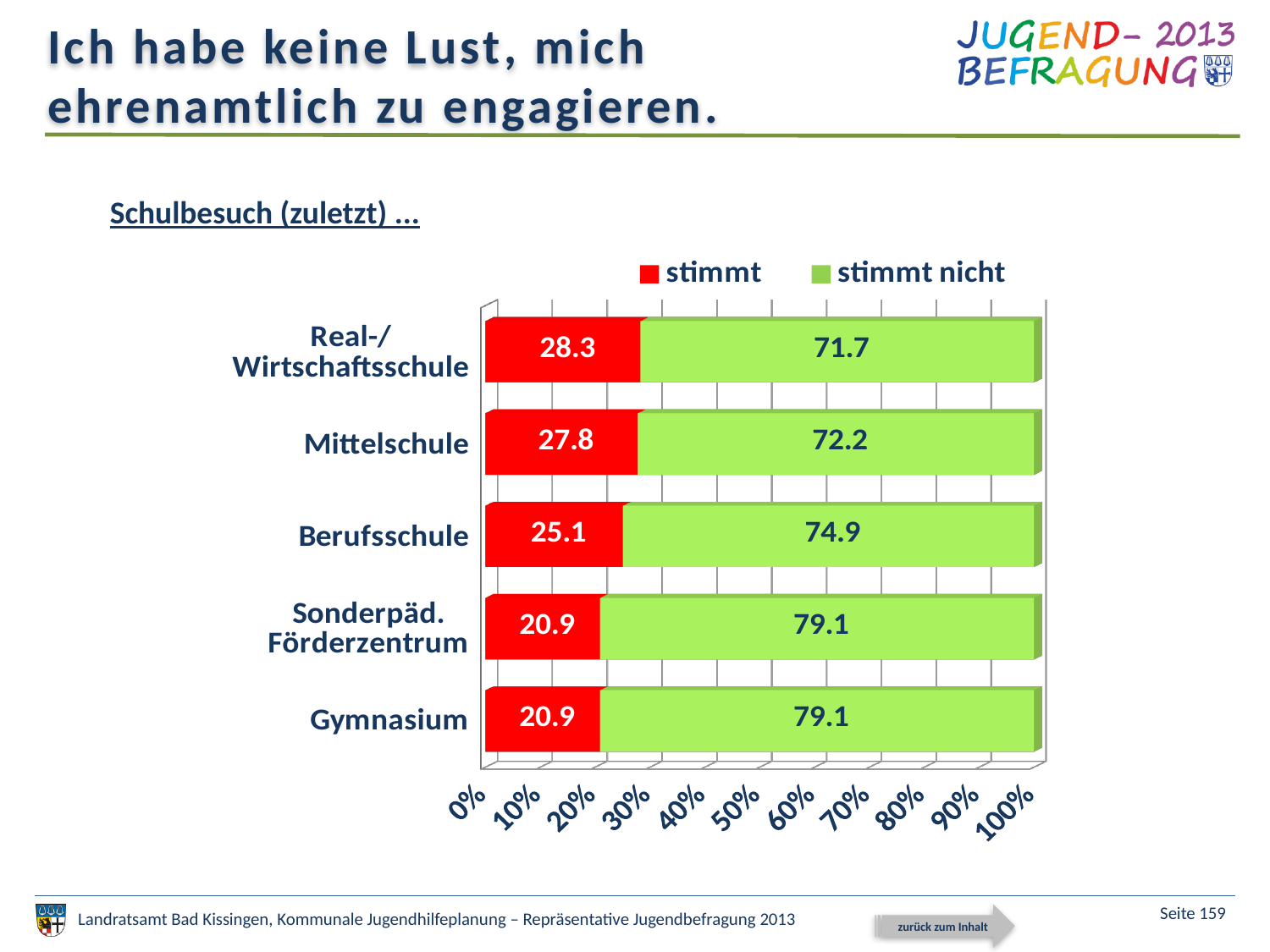
What is the 'stimmt nicht' value for Berufsschule? 74.9 Which is larger, the 'stimmt' value for Berufsschule or for Mittelschule? Mittelschule What is the 'stimmt' value for Mittelschule? 27.8 Which category has the lowest 'stimmt nicht' value? Real-/Wirtschaftsschule What is the total of the stacked bar for Sonderpäd. Förderzentrum? 100 How many series does the legend list? 2 What kind of chart is shown on the slide? Stacked bar chart Which colour represents the 'stimmt nicht' series? Green How many categories are shown on the chart? 5 What is the 'stimmt' value for Real-/Wirtschaftsschule? 28.3 What is the difference between the 'stimmt' values for Real-/Wirtschaftsschule and Gymnasium? 7.4 Which category has the highest 'stimmt' value? Real-/Wirtschaftsschule